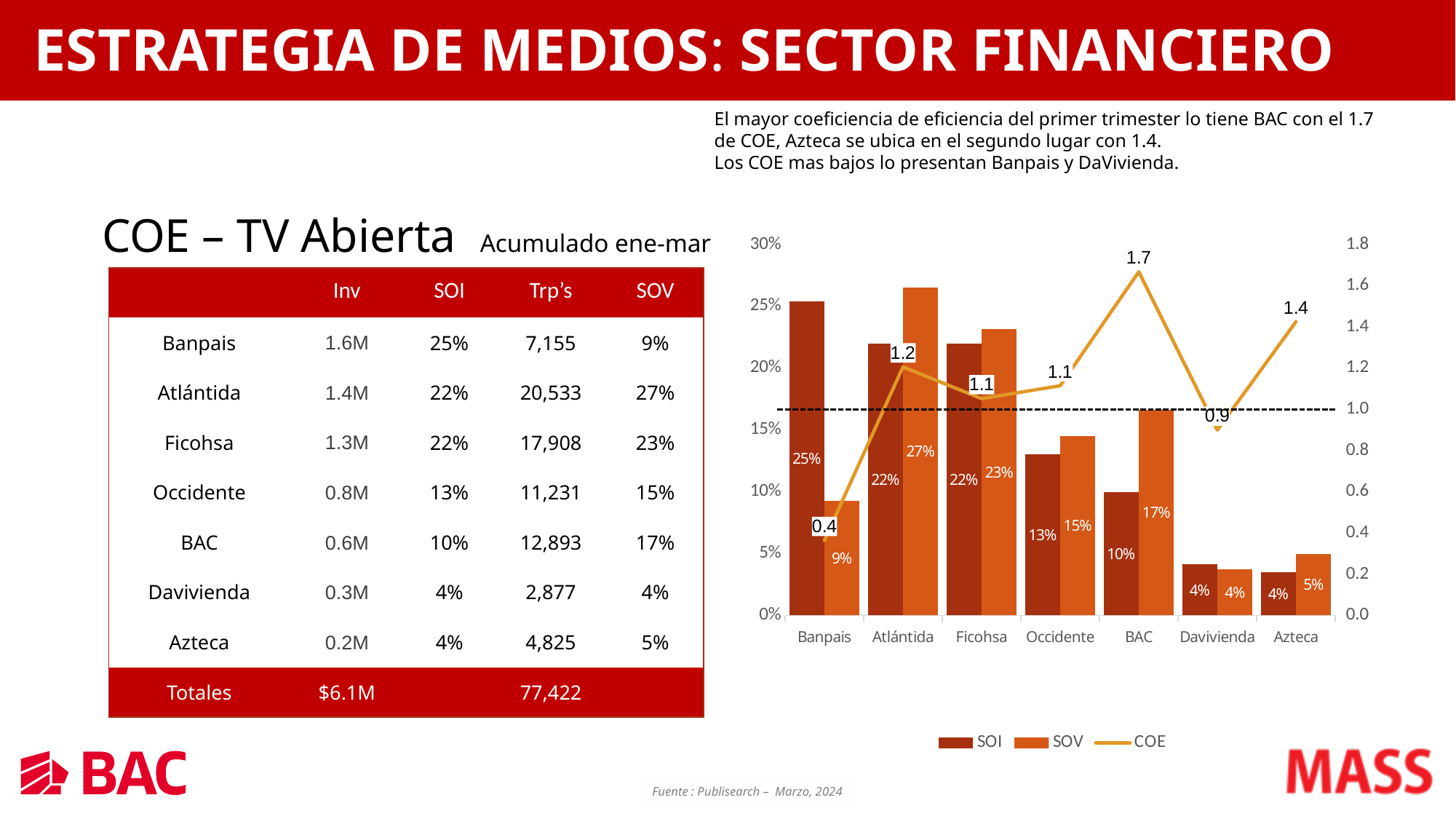
What is the COE value for BAC? 1.7 Which category has the lowest COE value? Banpais How many categories are shown on the x axis? 7 How many series does the legend list? 3 What is the SOI value for Banpais? 25% What is the COE value for Banpais? 0.4 What is the SOV value for Atlántida? 27% What is the SOV value for Azteca? 5% What kind of chart is shown on the slide? Combined bar and line chart Which is larger for Banpais, the SOI value or the SOV value? SOI What is the difference between the SOV and SOI values for BAC? 7% Which category has the highest COE value? BAC